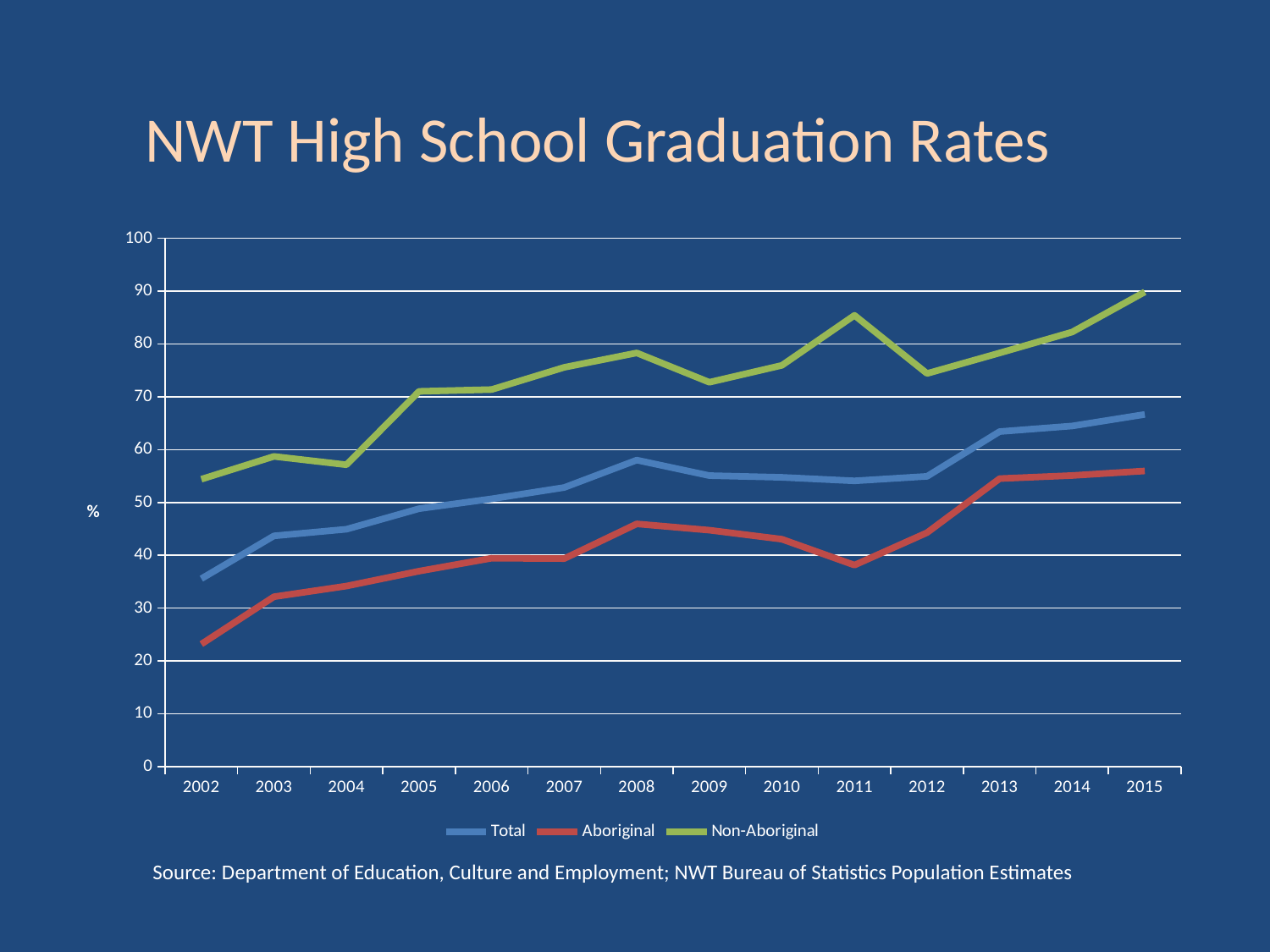
How many series does the legend list? 3 In which year is the Non-Aboriginal graduation rate highest? 2015 Is the Non-Aboriginal value for 2011 greater or less than 80? greater In 2008, which is larger: the Total rate or the Aboriginal rate? Total Is the Aboriginal value for 2002 greater or less than 30? less In which year is the Aboriginal graduation rate lowest? 2002 Is the Total value for 2015 greater or less than 60? greater How many years are shown along the x axis? 14 What is the title of the chart? NWT High School Graduation Rates What kind of chart is shown on the slide? line chart Does the Aboriginal graduation rate overall rise or fall from 2002 to 2015? rise